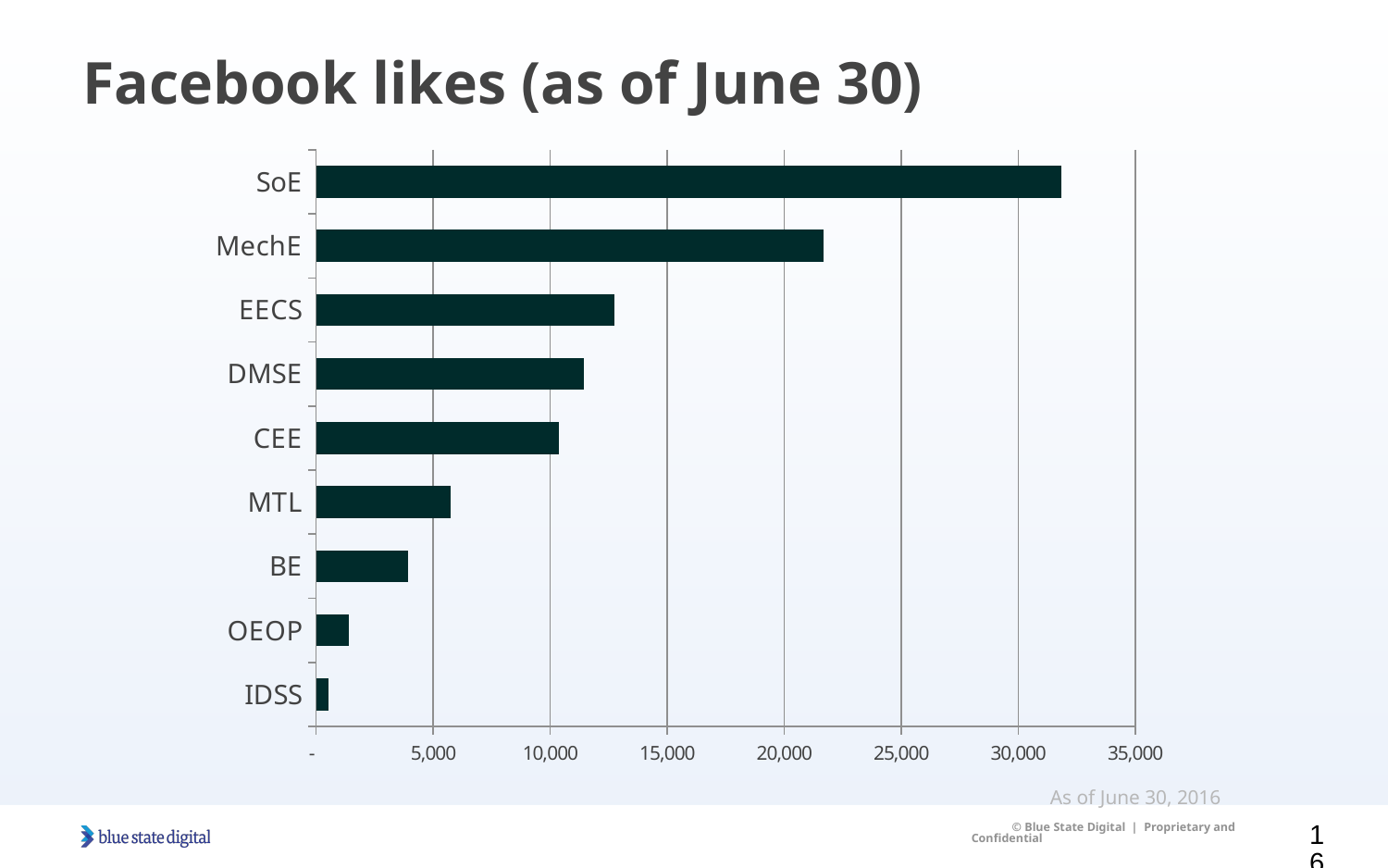
Which has more Facebook likes, EECS or DMSE? EECS What kind of chart is shown on the slide? Bar chart What is the title of the chart? Facebook likes (as of June 30) Is the value for EECS greater or less than 10,000? greater Is the value for SoE greater or less than 30,000? greater Is the value for MechE greater or less than 20,000? greater Which category has the lowest number of Facebook likes? IDSS Which has more Facebook likes, MTL or BE? MTL Do the bar values increase or decrease going from the top category to the bottom category? decrease Which category has the highest number of Facebook likes? SoE How many categories are plotted in the chart? 9